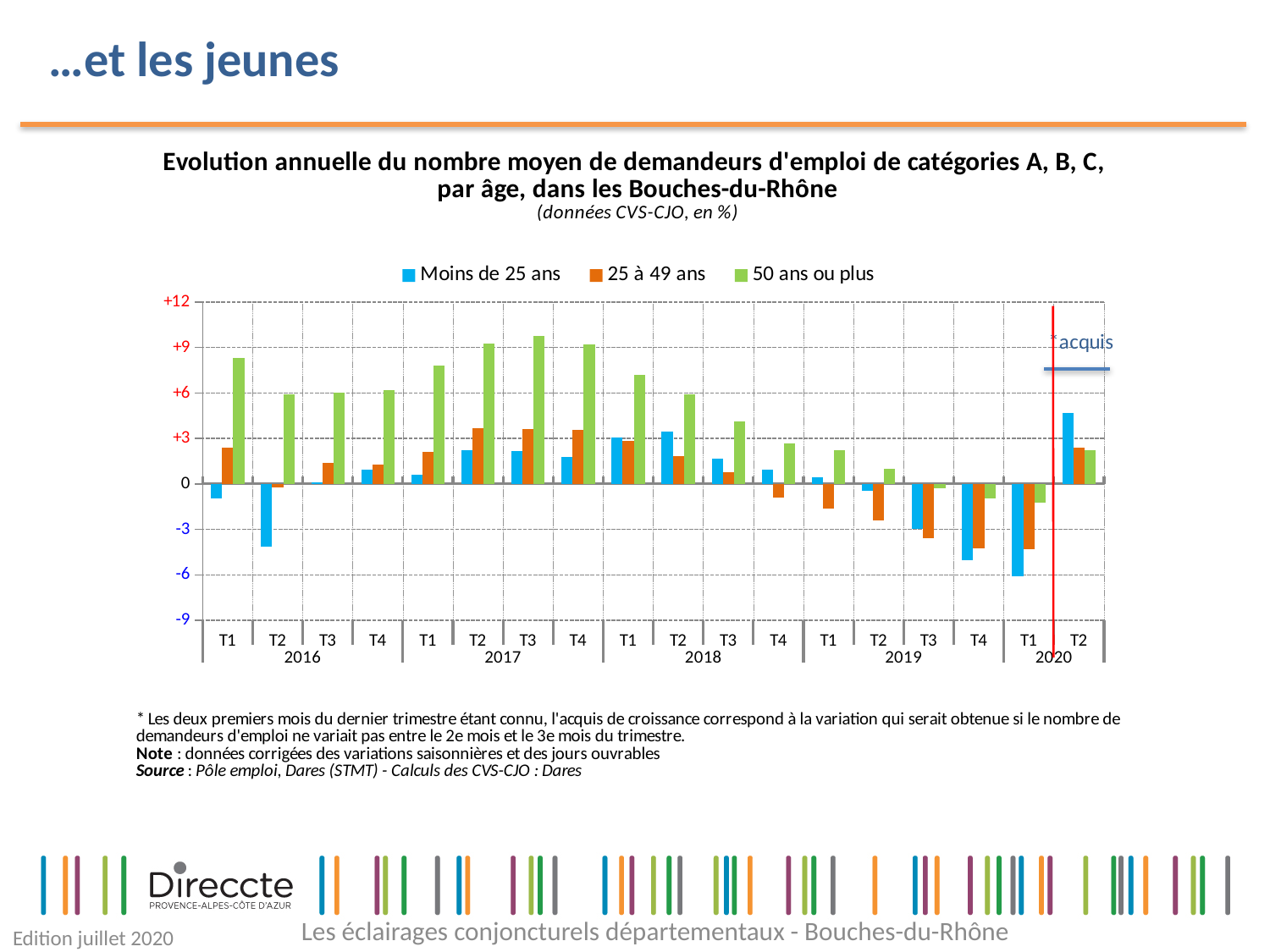
How many quarters (categories) are plotted along the x axis? 18 Is the value for '50 ans ou plus' in T3 2017 greater or less than +9? greater From T3 2017 to T1 2020, do the values for '50 ans ou plus' generally rise or fall? fall Which series is shown in green in the legend? 50 ans ou plus In T1 2016, which is larger: the value for 'Moins de 25 ans' or for '50 ans ou plus'? 50 ans ou plus Is the value for 'Moins de 25 ans' in T2 2016 greater or less than -3? less How many series does the legend list? 3 In which quarter does the '50 ans ou plus' series reach its highest value? T3 2017 Is the value for 'Moins de 25 ans' in T2 2020 greater or less than +3? greater In which quarter does the 'Moins de 25 ans' series reach its lowest value? T1 2020 What kind of chart is shown on the slide? bar chart